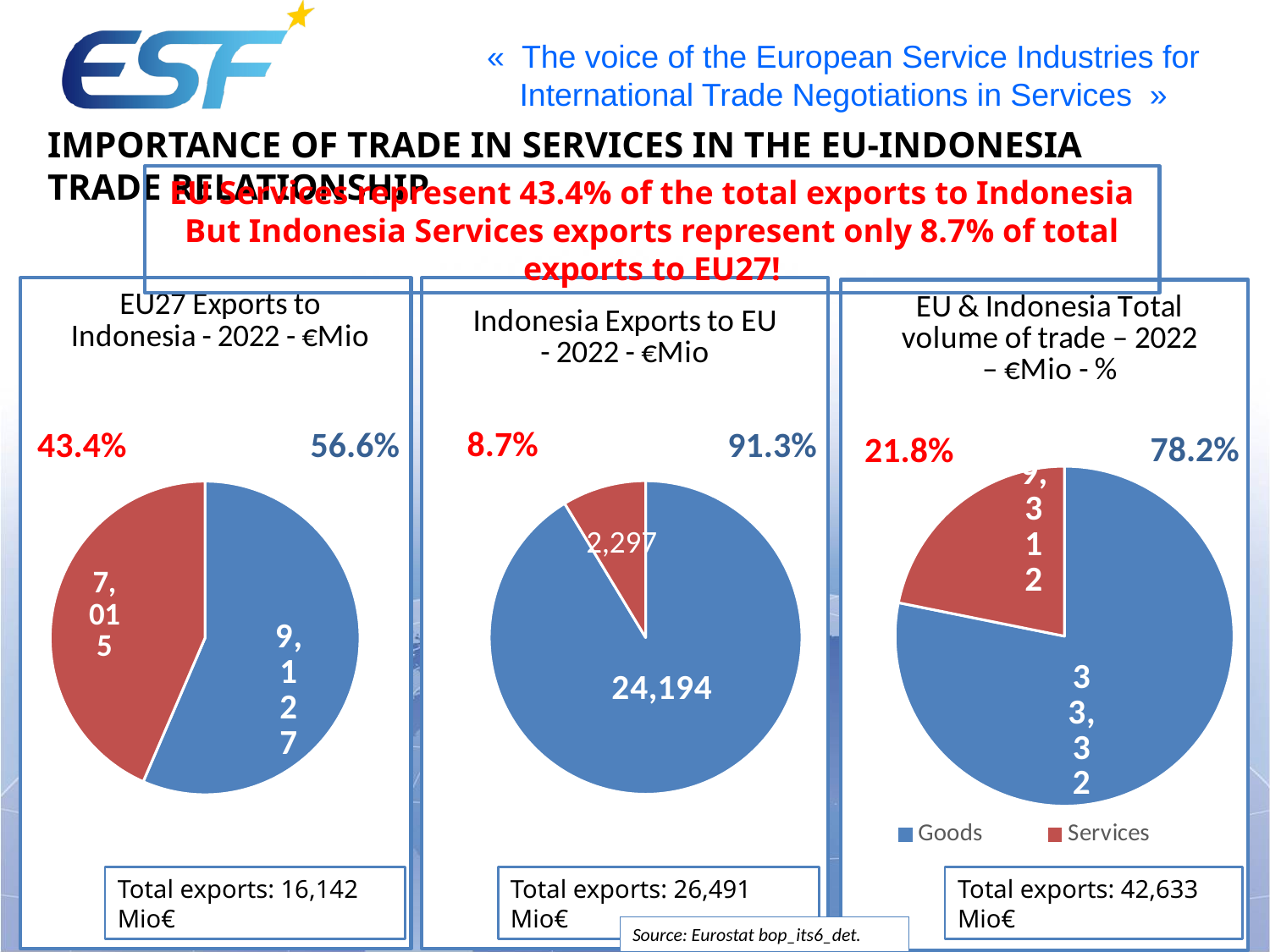
In the 'EU & Indonesia Total volume of trade – 2022' chart, which slice is larger, Goods or Services? Goods In the 'Indonesia Exports to EU - 2022 - €Mio' chart, what share of the pie is Goods? 91.3% In the 'Indonesia Exports to EU - 2022 - €Mio' chart, what is the value of the Services slice? 2,297 In the 'EU & Indonesia Total volume of trade – 2022' chart, what share of the pie is Services? 21.8% How many series does the legend on the 'EU & Indonesia Total volume of trade – 2022' chart list? 2 In the 'Indonesia Exports to EU - 2022 - €Mio' chart, what is the value of the Goods slice? 24,194 In the 'EU27 Exports to Indonesia - 2022 - €Mio' chart, what is the value of the Services slice? 7,015 In the 'Indonesia Exports to EU - 2022 - €Mio' chart, what is the difference between the Goods and Services values? 21,897 What kind of charts are shown on the slide? Pie charts Which colour represents Services in the pie charts? Red In the 'EU27 Exports to Indonesia - 2022 - €Mio' chart, what share of the pie is Services? 43.4% In the 'EU27 Exports to Indonesia - 2022 - €Mio' chart, what is the value of the Goods slice? 9,127